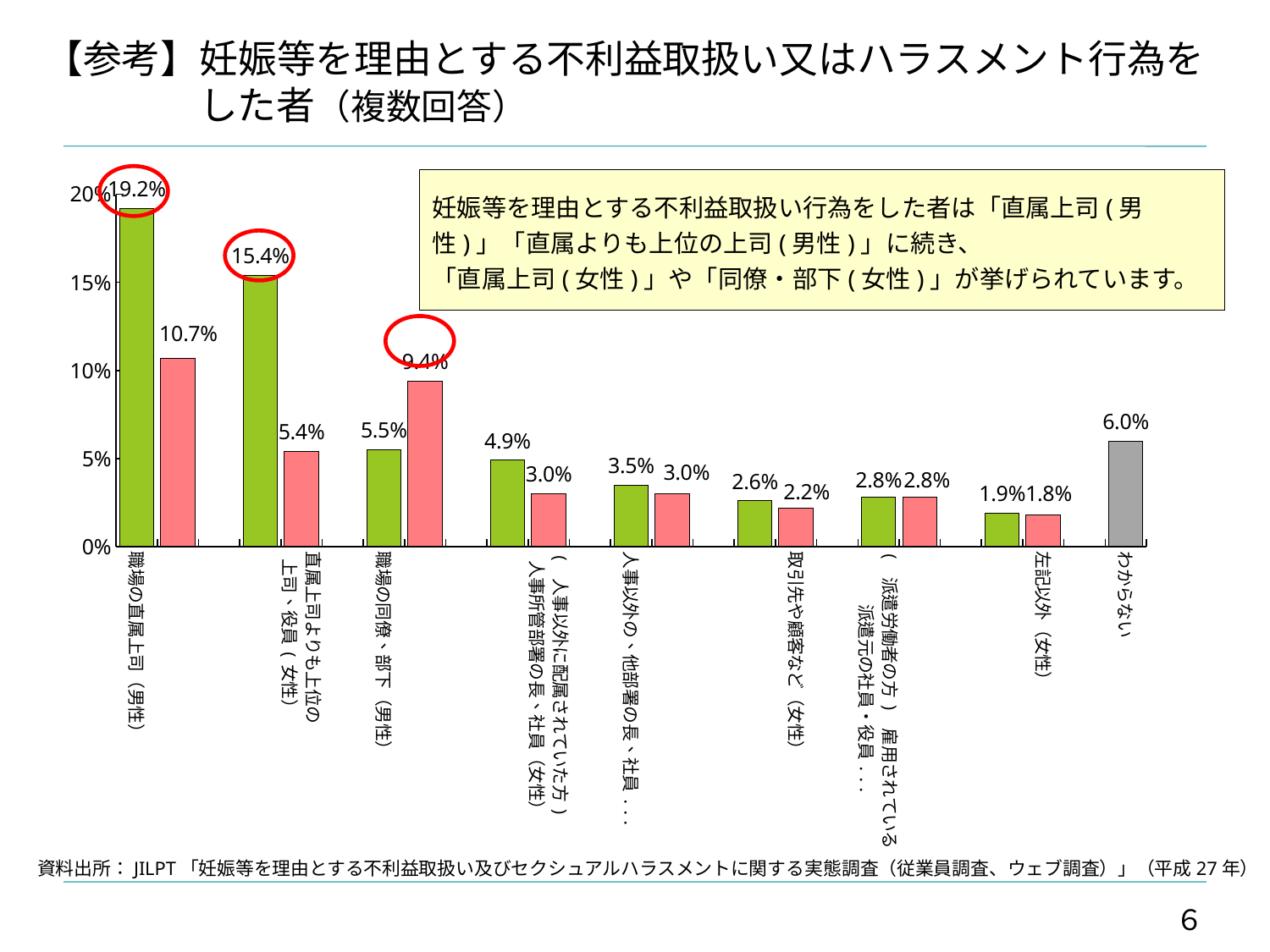
Which category has the lowest value? 左記以外（女性） What is the value for 取引先や顧客など（女性）? 2.2% What is the value for わからない? 6.0% How many bars are plotted in the chart? 17 What is the difference between the highest value (19.2%) and the second highest value (15.4%)? 3.8 percentage points What is the value for 職場の直属上司（男性）? 19.2% Which is larger: the value for 職場の直属上司（男性） or the value for わからない? 職場の直属上司（男性） What colour is the bar for わからない? gray What kind of chart is shown on the slide? bar chart What is the value for 職場の同僚・部下（男性）? 5.5% Which category has the highest value? 職場の直属上司（男性） What is the value for 直属上司よりも上位の上司・役員（女性）? 5.4%